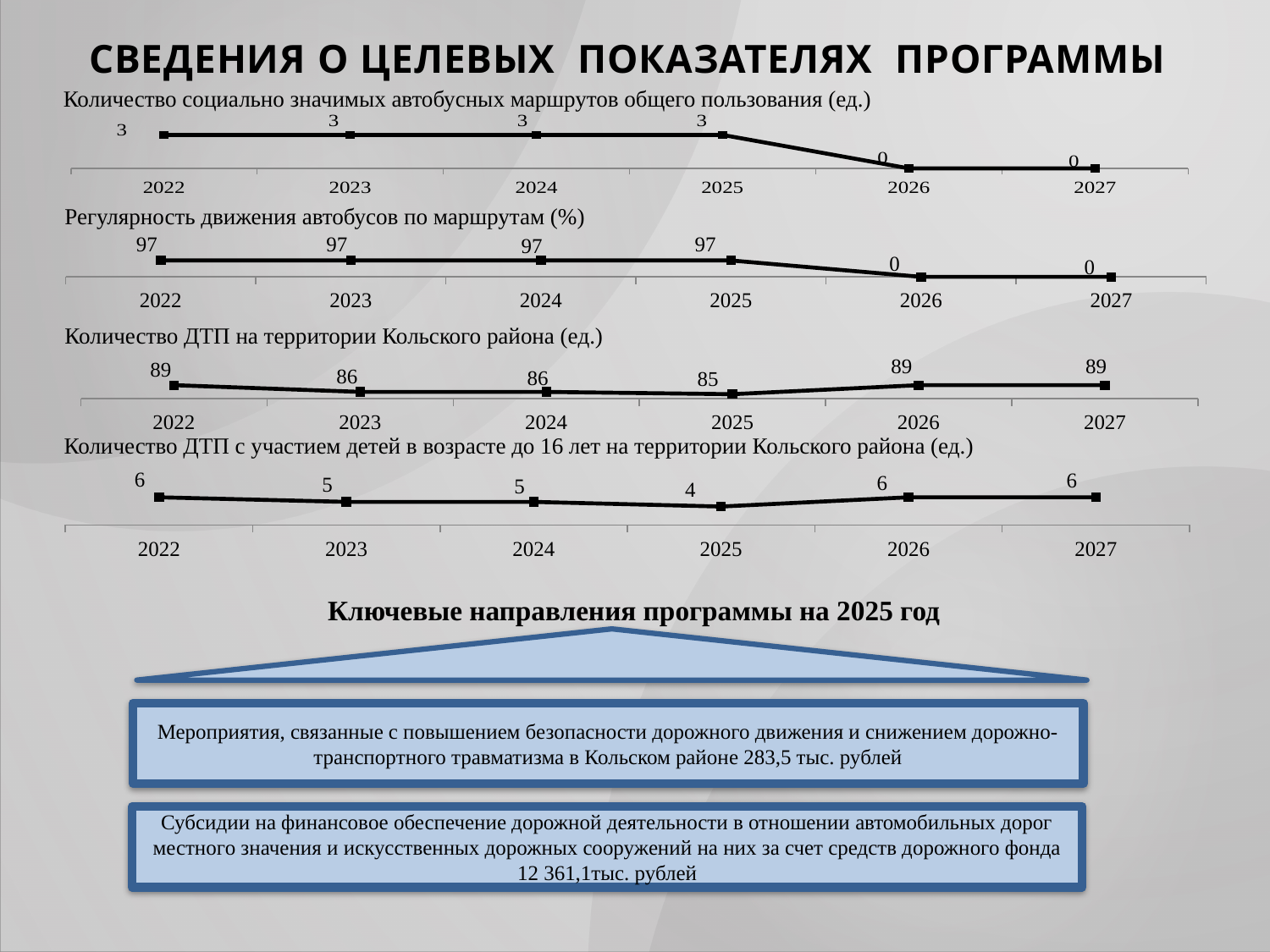
In the chart 'Регулярность движения автобусов по маршрутам (%)', what is the value for 2024? 97 What kind of chart is 'Количество ДТП с участием детей в возрасте до 16 лет на территории Кольского района (ед.)'? line chart How many years are plotted in the chart 'Регулярность движения автобусов по маршрутам (%)'? 6 In the chart 'Количество ДТП на территории Кольского района (ед.)', what is the value for 2025? 85 In the chart 'Количество ДТП на территории Кольского района (ед.)', what is the difference between the values for 2022 and 2025? 4 In the chart 'Количество ДТП с участием детей в возрасте до 16 лет на территории Кольского района (ед.)', which year has the lowest value? 2025 In the chart 'Количество социально значимых автобусных маршрутов общего пользования (ед.)', what is the value for 2026? 0 In the chart 'Количество ДТП на территории Кольского района (ед.)', which is larger, the value for 2023 or the value for 2026? 2026 In the chart 'Количество ДТП с участием детей в возрасте до 16 лет на территории Кольского района (ед.)', what is the difference between the values for 2026 and 2025? 2 In the chart 'Количество ДТП с участием детей в возрасте до 16 лет на территории Кольского района (ед.)', what is the value for 2022? 6 In the chart 'Количество ДТП на территории Кольского района (ед.)', which year has the lowest value? 2025 In the chart 'Количество социально значимых автобусных маршрутов общего пользования (ед.)', does the value rise or fall from 2025 to 2026? fall